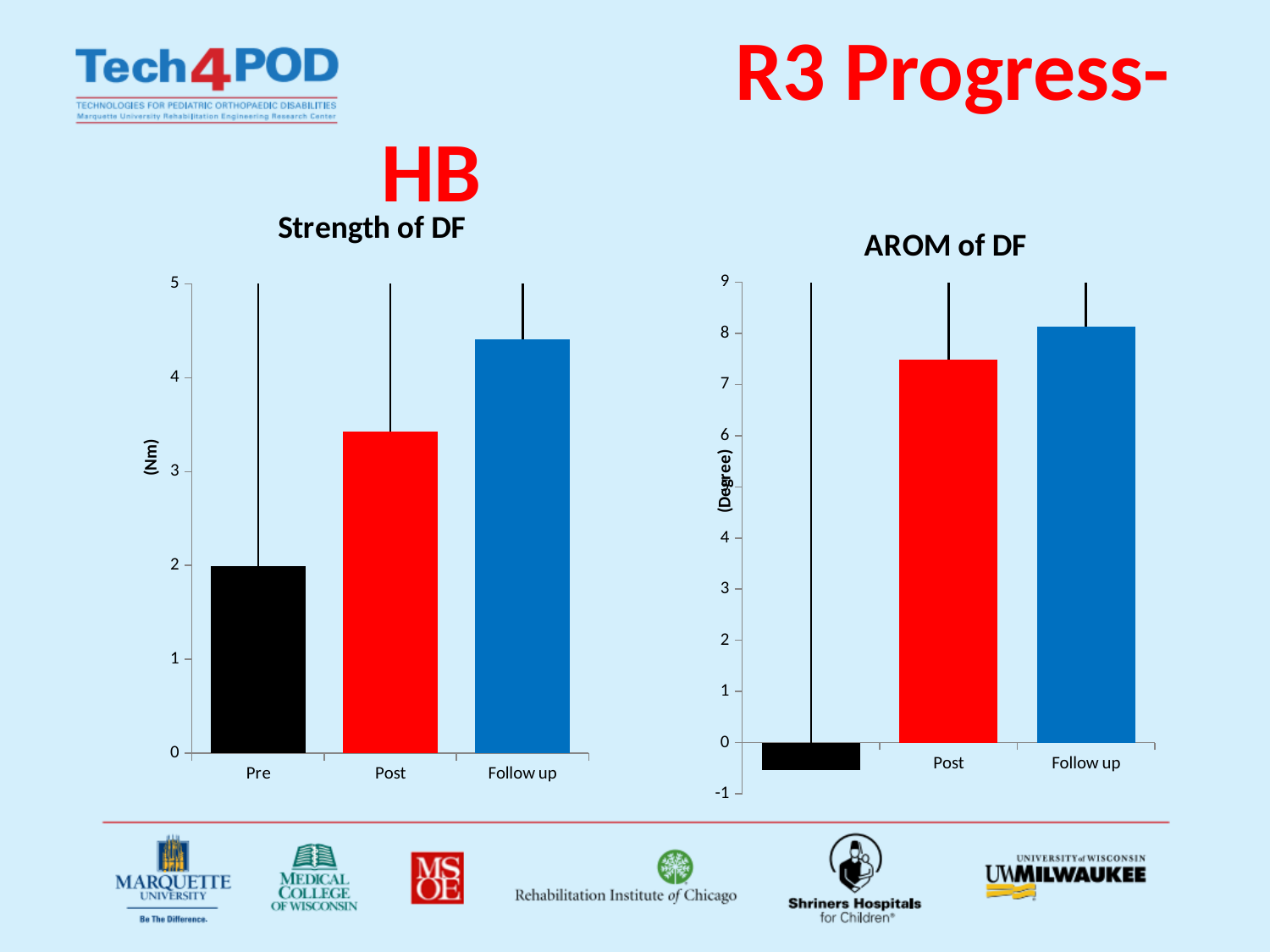
In the 'Strength of DF' chart, is the value for Follow up greater or less than 4? greater In the 'Strength of DF' chart, which category has the highest value? Follow up In the 'Strength of DF' chart, do the values rise or fall from Pre to Follow up? rise How many categories are shown in the 'Strength of DF' chart? 3 In the 'AROM of DF' chart, is the value for Post greater or less than 7? greater In the 'AROM of DF' chart, which is larger, Post or Follow up? Follow up In the 'Strength of DF' chart, is the value for Post greater or less than 3? greater What kind of chart is the 'Strength of DF' chart? bar chart What is the y-axis unit label on the 'Strength of DF' chart? (Nm) In the 'Strength of DF' chart, which category has the lowest value? Pre What is the y-axis unit label on the 'AROM of DF' chart? (Degree)